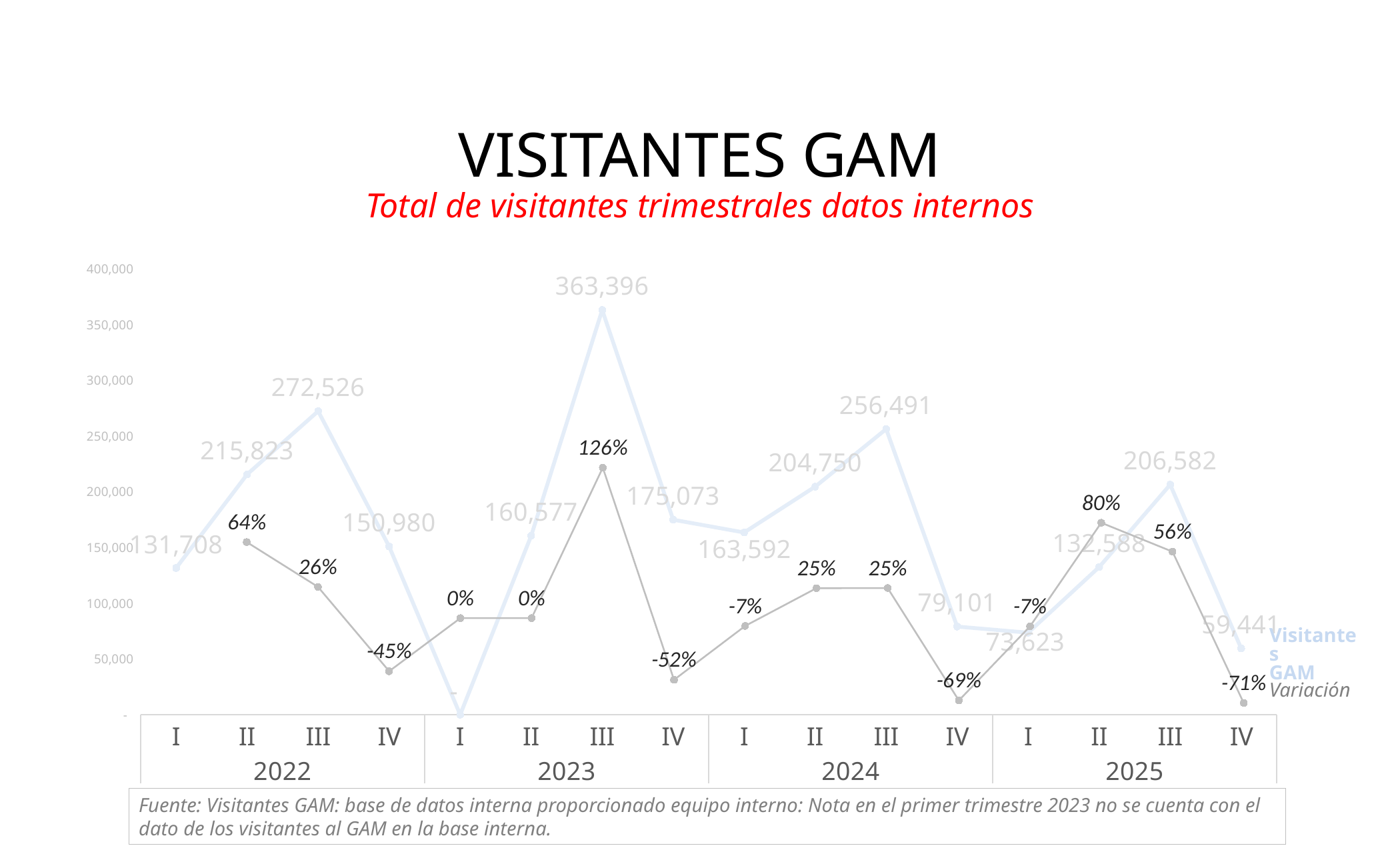
What is the difference between Visitantes GAM in quarter III of 2022 and quarter II of 2022? 56,703 What is the Variación value for quarter III of 2023? 126% How many series does the legend list? 2 What is the value of Visitantes GAM for quarter III of 2023? 363,396 What is the Variación value for quarter IV of 2025? -71% What is the subtitle shown in red below the chart title? Total de visitantes trimestrales datos internos How many quarters are plotted along the x axis? 16 In which quarter does Visitantes GAM reach its highest value? III 2023 Which is larger, Visitantes GAM in quarter III of 2024 or quarter III of 2025? III 2024 What is the value of Visitantes GAM for quarter IV of 2025? 59,441 In which quarter is the Variación value lowest? IV 2025 What type of chart is shown on the slide? Line chart